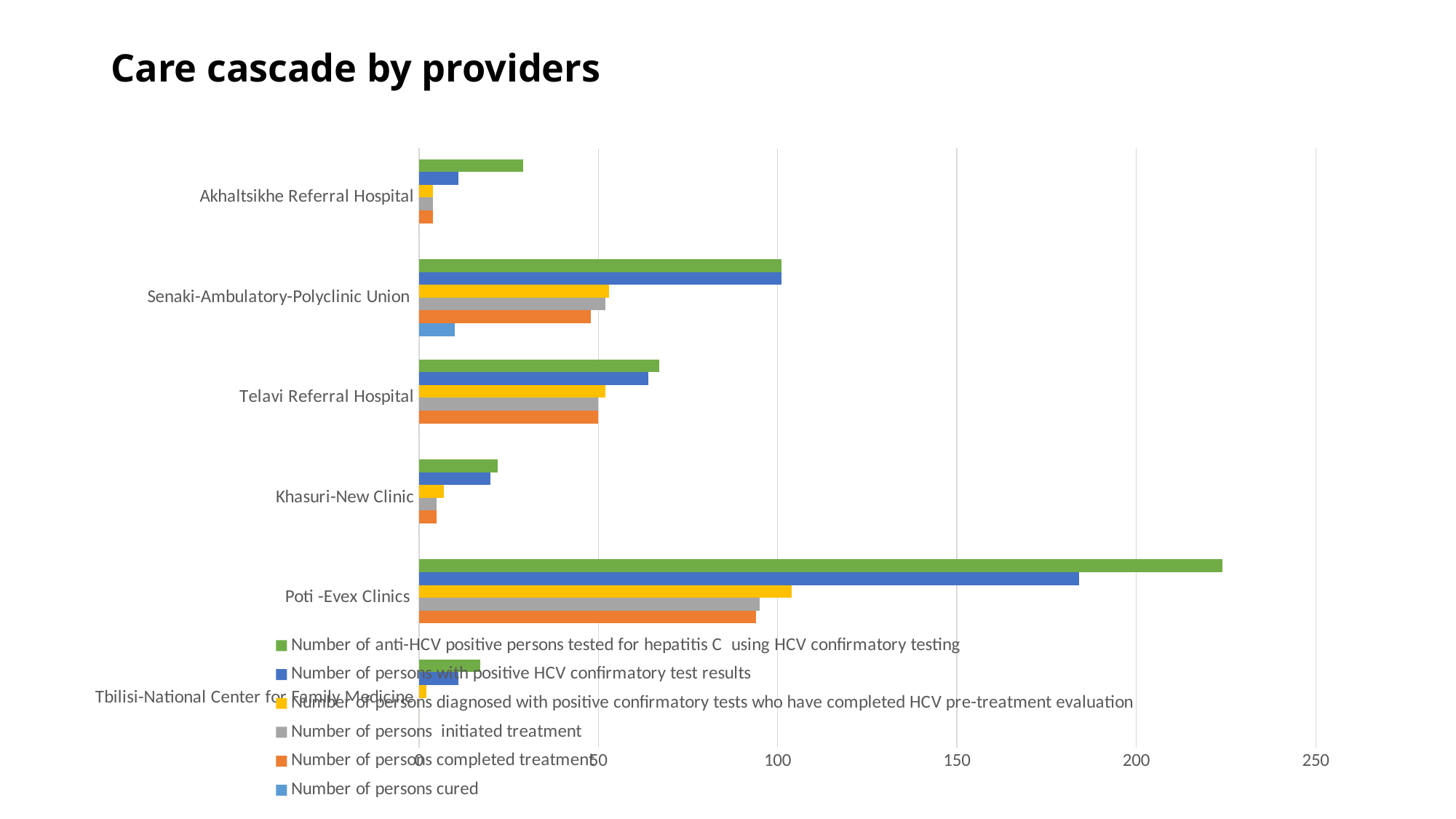
Which provider has the highest number of anti-HCV positive persons tested using HCV confirmatory testing? Poti -Evex Clinics Is the number of anti-HCV positive persons tested using HCV confirmatory testing for Poti -Evex Clinics greater or less than 200? greater Which has more anti-HCV positive persons tested using HCV confirmatory testing, Poti -Evex Clinics or Senaki-Ambulatory-Polyclinic Union? Poti -Evex Clinics Is the number of anti-HCV positive persons tested using HCV confirmatory testing for Akhaltsikhe Referral Hospital greater or less than 50? less What kind of chart is shown on the slide? bar chart How many providers (categories) are shown on the chart? 6 How many series does the legend list? 6 Is the number of anti-HCV positive persons tested using HCV confirmatory testing for Telavi Referral Hospital greater or less than 50? greater Which series is shown in green in the legend? Number of anti-HCV positive persons tested for hepatitis C using HCV confirmatory testing What is the title of the chart? Care cascade by providers